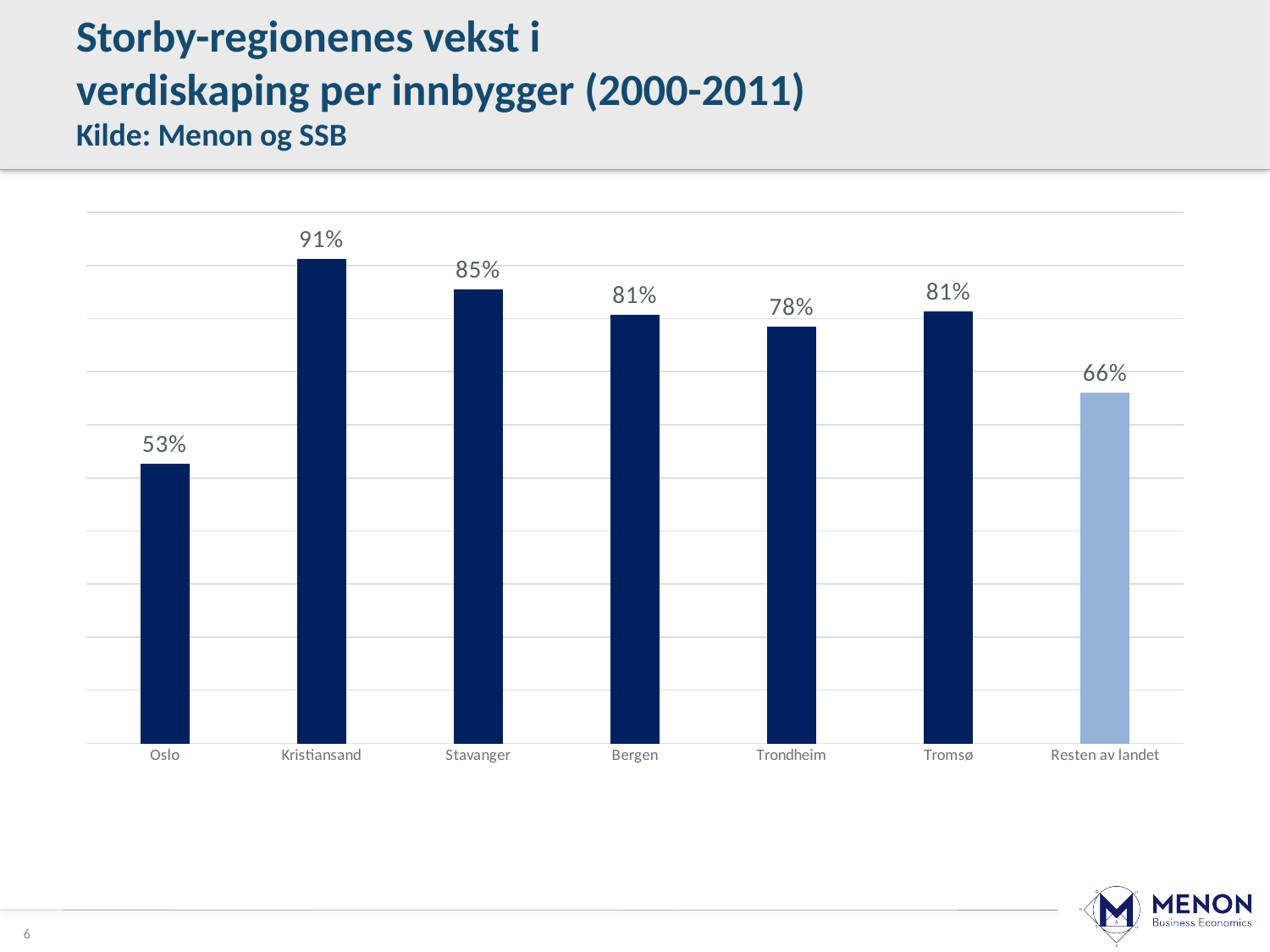
What is the value for Kristiansand? 91% What is the value for Resten av landet? 66% Which bar is shown in a lighter blue colour than the others? Resten av landet Which is larger, the value for Stavanger or the value for Bergen? Stavanger What is the value for Trondheim? 78% Which category has the highest value? Kristiansand Which category has the lowest value? Oslo What is the value for Oslo? 53% What is the difference between the values for Stavanger and Resten av landet? 19% What kind of chart is shown on the slide? Bar chart What is the difference between the values for Kristiansand and Oslo? 38% How many categories are shown on the x axis? 7